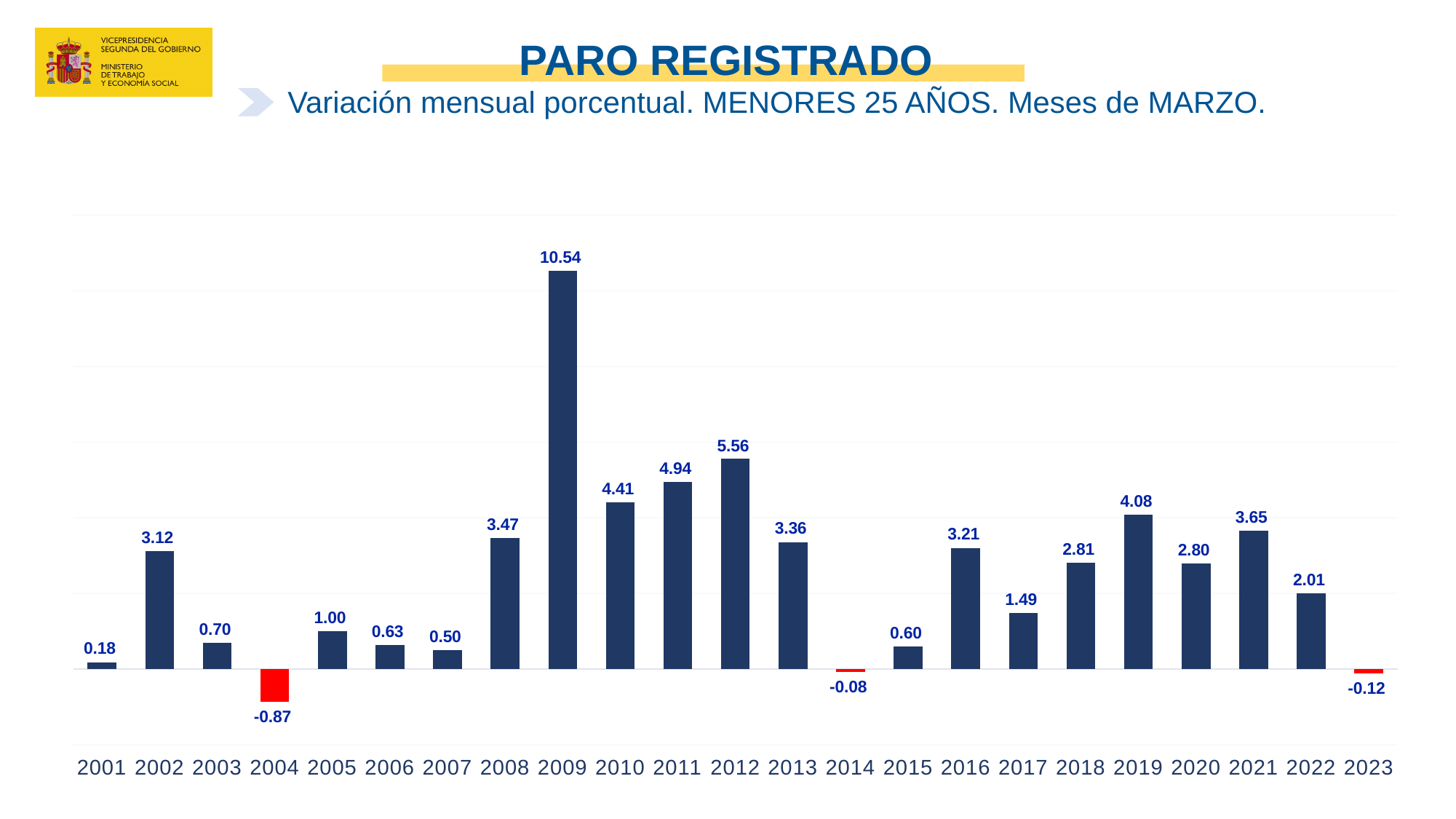
What is the value for 2009? 10.54 What kind of chart is shown on the slide? bar chart Which year has the lowest value? 2004 Do the values rise or fall from 2019 to 2023? fall Which year has the highest value? 2009 What is the difference between the values for 2012 and 2011? 0.62 How many years have a negative value? 3 How many years are shown on the x axis? 23 What colour are the bars with negative values? red What is the value for 2017? 1.49 What is the value for 2023? -0.12 Which is larger, the value for 2019 or the value for 2021? 2019